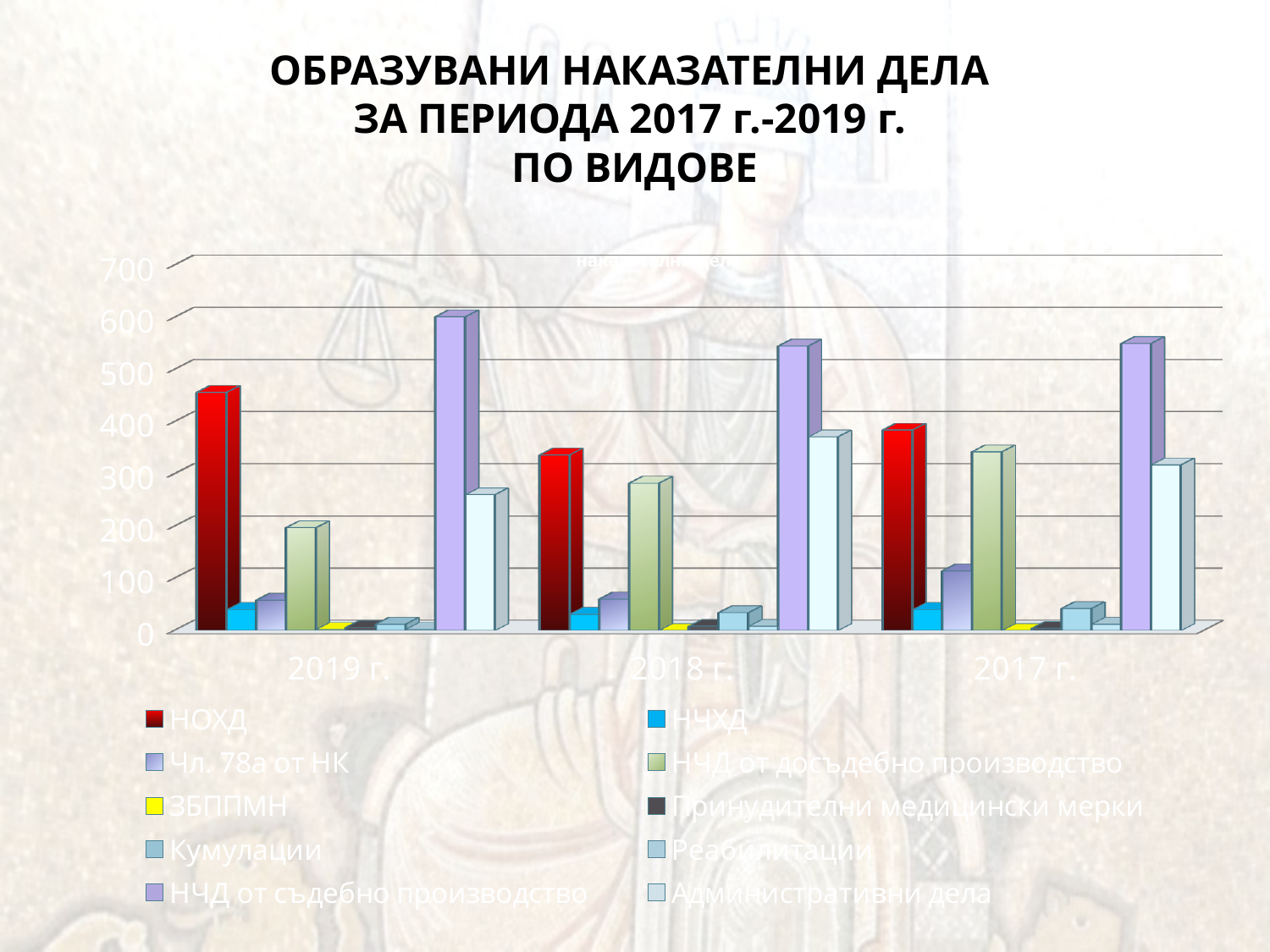
What kind of chart is shown on the slide? bar chart Is the value for Административни дела in 2018 г. greater or less than 300? greater How many year categories are shown on the x axis? 3 Which is larger, the value for Административни дела in 2018 г. or in 2019 г.? 2018 г. In which year is the value for НЧД от досъдебно производство the highest? 2017 г. Which series has the highest value for 2019 г.? НЧД от съдебно производство In which year is the value for НОХД the highest? 2019 г. How many series does the legend list? 10 Is the value for НОХД in 2019 г. greater or less than 400? greater Do the values for НЧД от досъдебно производство rise or fall along the x axis from 2019 г. to 2017 г.? rise Is the value for НЧД от съдебно производство in 2019 г. greater or less than 500? greater Which is larger, the value for НОХД in 2019 г. or in 2018 г.? 2019 г.